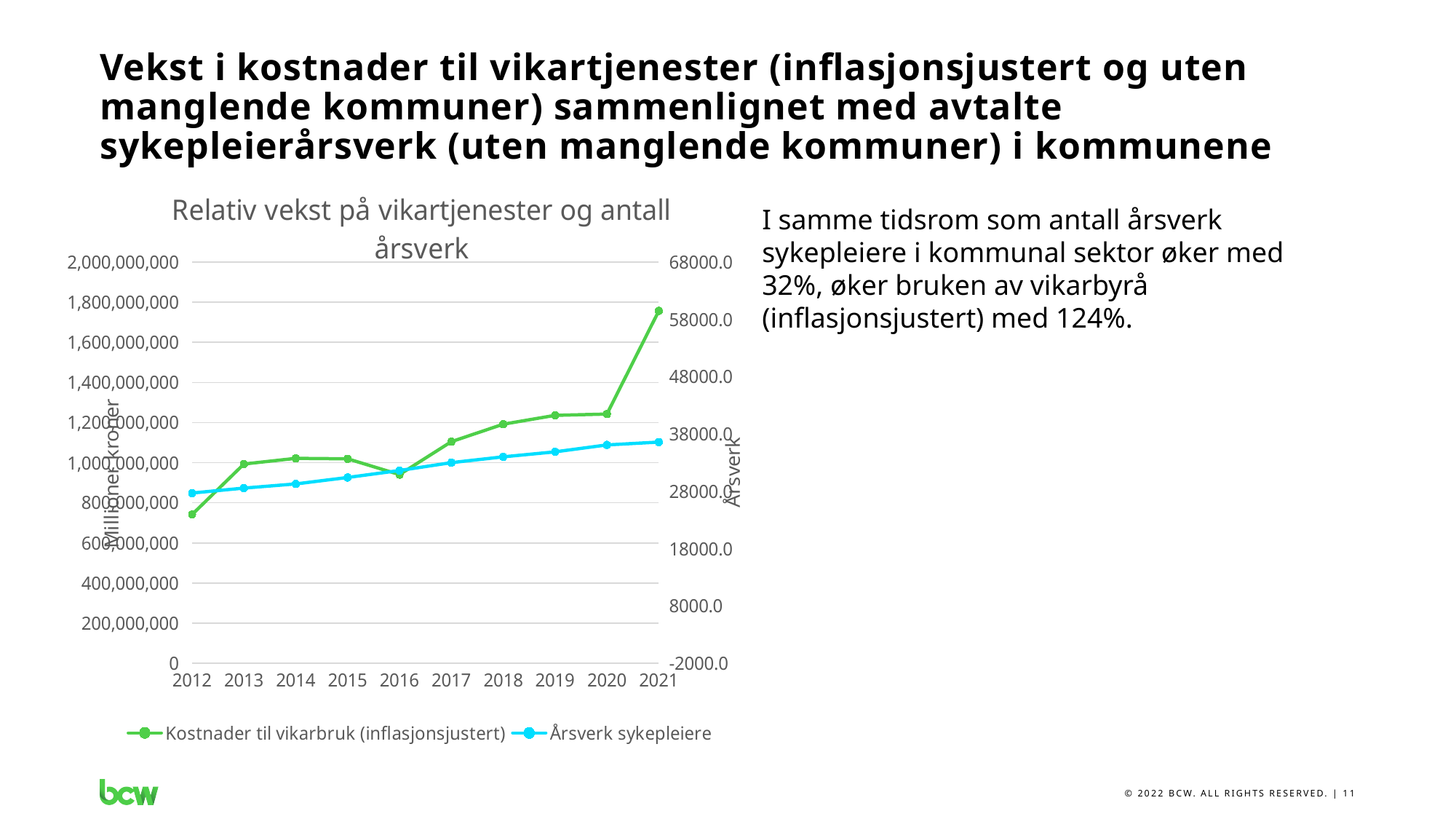
In which year is the value for Kostnader til vikarbruk (inflasjonsjustert) lowest? 2012 How many years are plotted along the x axis? 10 Which series is drawn in green? Kostnader til vikarbruk (inflasjonsjustert) What kind of chart is shown on the slide? line chart Is the value for Kostnader til vikarbruk (inflasjonsjustert) in 2021 greater or less than 1,600,000,000? greater Does the Årsverk sykepleiere series rise or fall from 2012 to 2021? rise What is the title of the chart? Relativ vekst på vikartjenester og antall årsverk How many series does the legend list? 2 Which year has the higher value for Kostnader til vikarbruk (inflasjonsjustert), 2013 or 2016? 2013 In which year is the value for Kostnader til vikarbruk (inflasjonsjustert) highest? 2021 Is the value for Årsverk sykepleiere in 2012 greater or less than 18000.0 on the right axis? greater Is the value for Kostnader til vikarbruk (inflasjonsjustert) in 2012 greater or less than 800,000,000? less